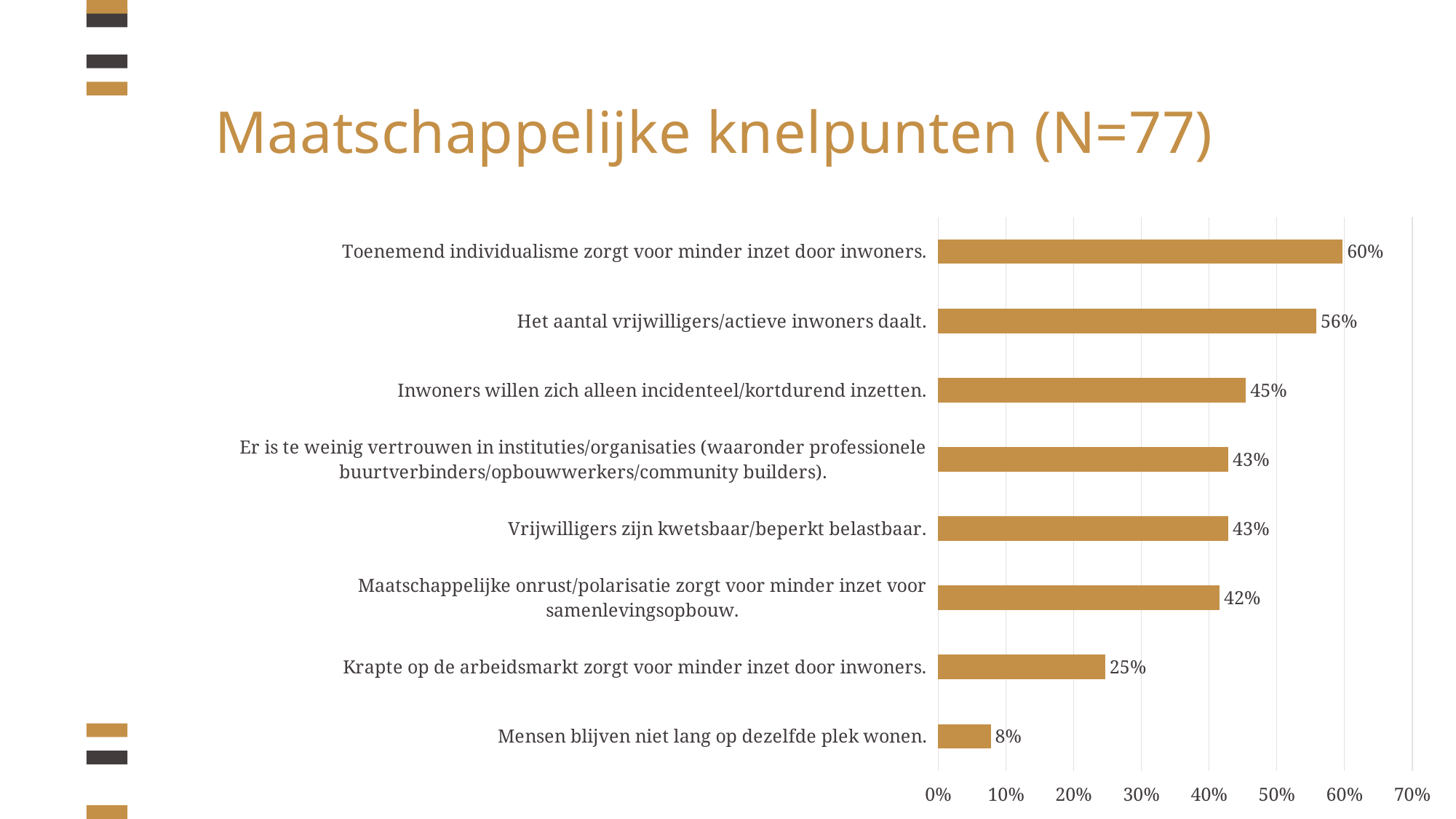
How many categories are shown in the chart? 8 Which is larger: the value for "Inwoners willen zich alleen incidenteel/kortdurend inzetten." or the value for "Krapte op de arbeidsmarkt zorgt voor minder inzet door inwoners."? Inwoners willen zich alleen incidenteel/kortdurend inzetten. What is the value for "Het aantal vrijwilligers/actieve inwoners daalt."? 56% What is the difference between the values for "Inwoners willen zich alleen incidenteel/kortdurend inzetten." and "Mensen blijven niet lang op dezelfde plek wonen."? 37% What is the value for "Toenemend individualisme zorgt voor minder inzet door inwoners."? 60% Which category has the highest value? Toenemend individualisme zorgt voor minder inzet door inwoners. What kind of chart is shown on the slide? bar chart What is the title of the slide? Maatschappelijke knelpunten (N=77) Which category has the lowest value? Mensen blijven niet lang op dezelfde plek wonen. What is the difference between the values for "Toenemend individualisme zorgt voor minder inzet door inwoners." and "Het aantal vrijwilligers/actieve inwoners daalt."? 4% Is the value for "Maatschappelijke onrust/polarisatie zorgt voor minder inzet voor samenlevingsopbouw." greater or less than 50%? less What is the value for "Krapte op de arbeidsmarkt zorgt voor minder inzet door inwoners."? 25%